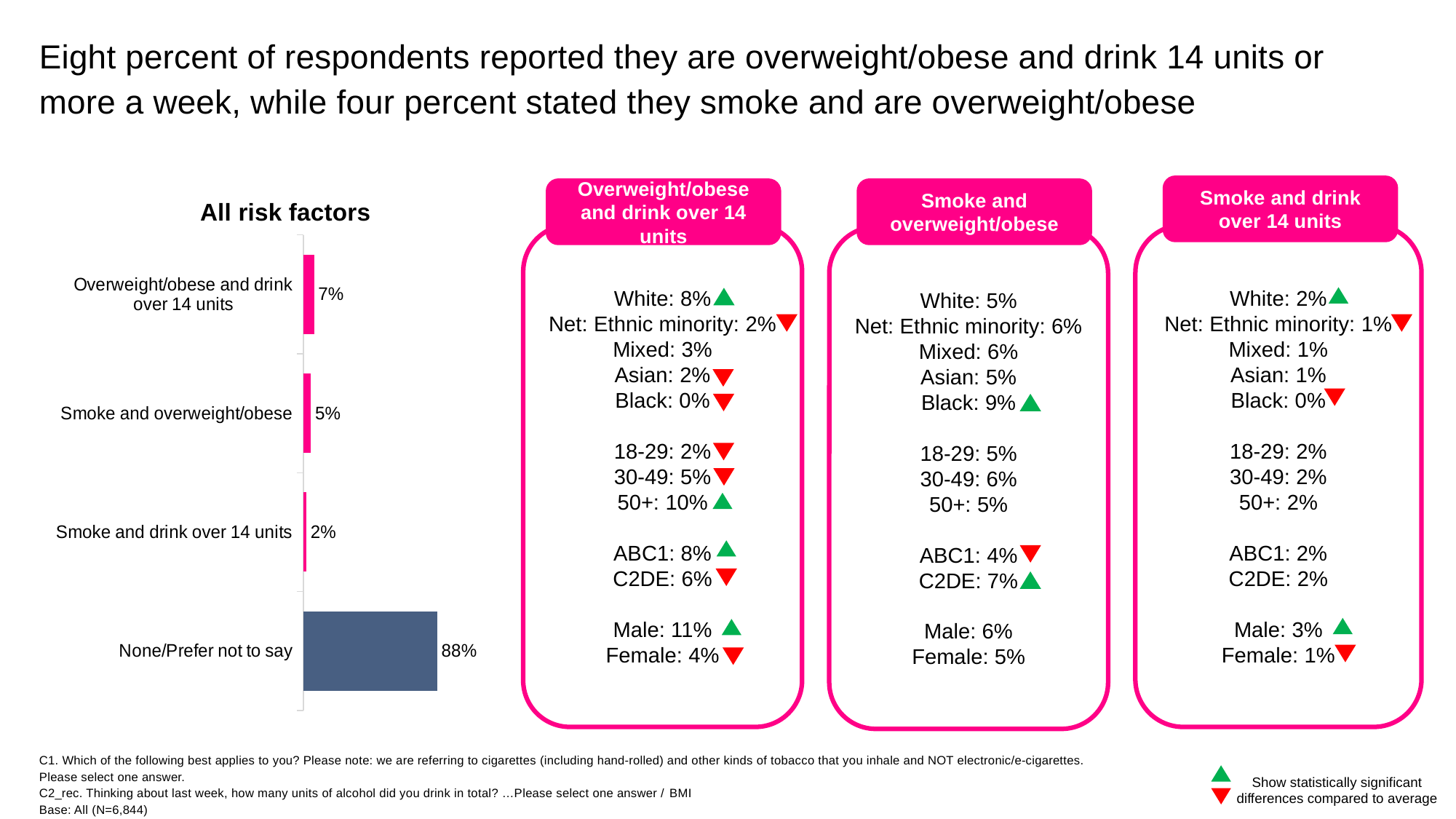
What is the value for 'Smoke and overweight/obese' in the 'All risk factors' chart? 5% What kind of chart is the 'All risk factors' chart? Bar chart In the 'All risk factors' chart, which is larger: 'Smoke and overweight/obese' or 'Smoke and drink over 14 units'? Smoke and overweight/obese Which category has the lowest value in the 'All risk factors' chart? Smoke and drink over 14 units In the 'All risk factors' chart, what is the difference between 'None/Prefer not to say' and 'Smoke and overweight/obese'? 83% Which category has the highest value in the 'All risk factors' chart? None/Prefer not to say In the 'All risk factors' chart, what is the difference between 'Overweight/obese and drink over 14 units' and 'Smoke and drink over 14 units'? 5% How many categories are shown in the 'All risk factors' chart? 4 What is the value for 'None/Prefer not to say' in the 'All risk factors' chart? 88% What is the title of the bar chart on the slide? All risk factors What is the value for 'Overweight/obese and drink over 14 units' in the 'All risk factors' chart? 7% What is the value for 'Smoke and drink over 14 units' in the 'All risk factors' chart? 2%